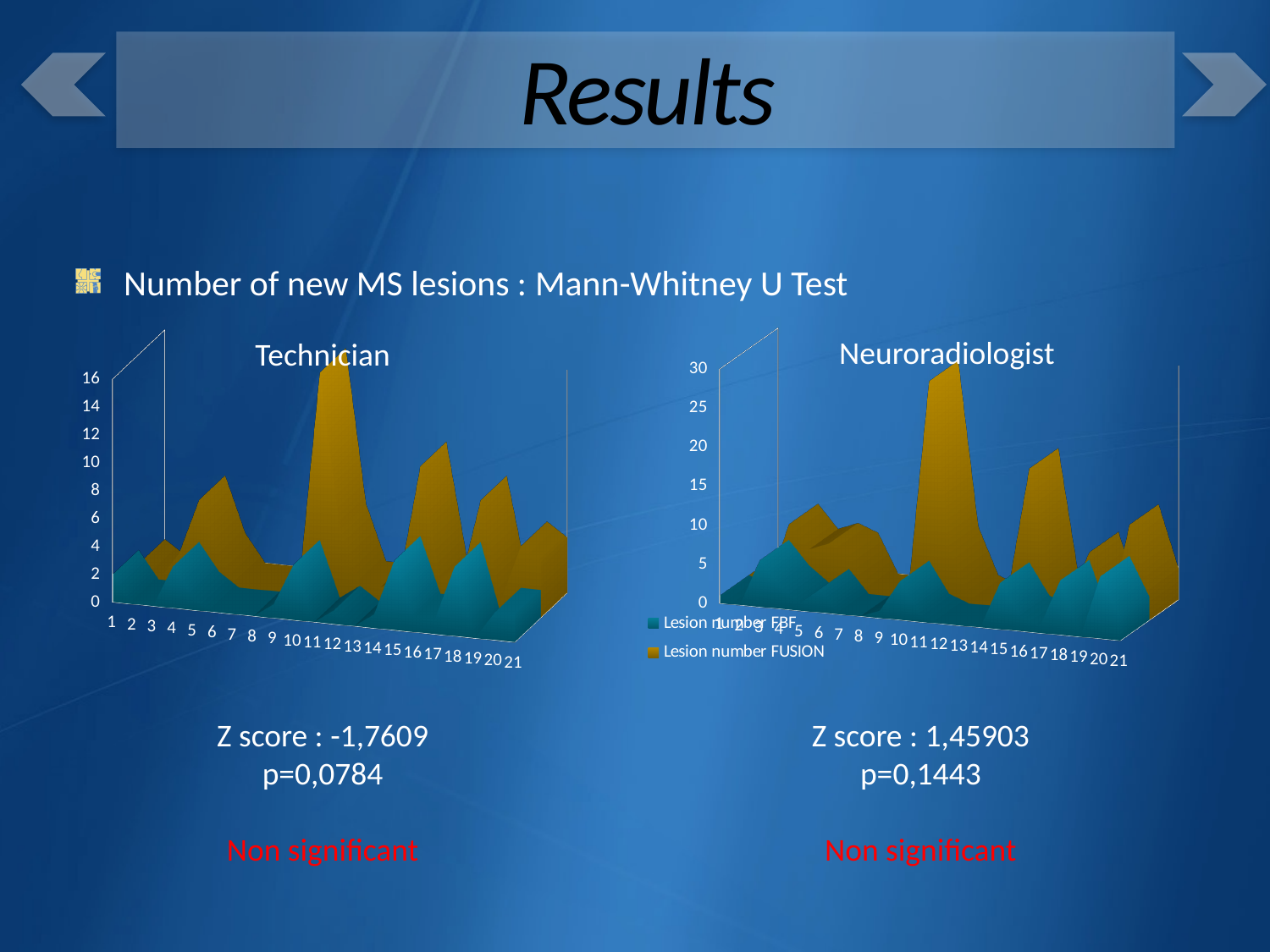
How many series does the legend of the Neuroradiologist chart list? 2 How many categories are shown on the x axis of the Technician chart? 21 What kind of chart is the Neuroradiologist chart? Area chart In the Neuroradiologist chart, is the highest value of Lesion number FUSION greater or less than 25? greater How many categories are shown on the x axis of the Neuroradiologist chart? 21 In the Neuroradiologist chart, is the highest value of Lesion number FBF greater or less than 15? less What kind of chart is the Technician chart? Area chart What is the title of the chart on the left of the slide? Technician What are the two series named in the legend of the Neuroradiologist chart? Lesion number FBF and Lesion number FUSION In the Neuroradiologist chart, which series reaches the higher peak value, Lesion number FBF or Lesion number FUSION? Lesion number FUSION